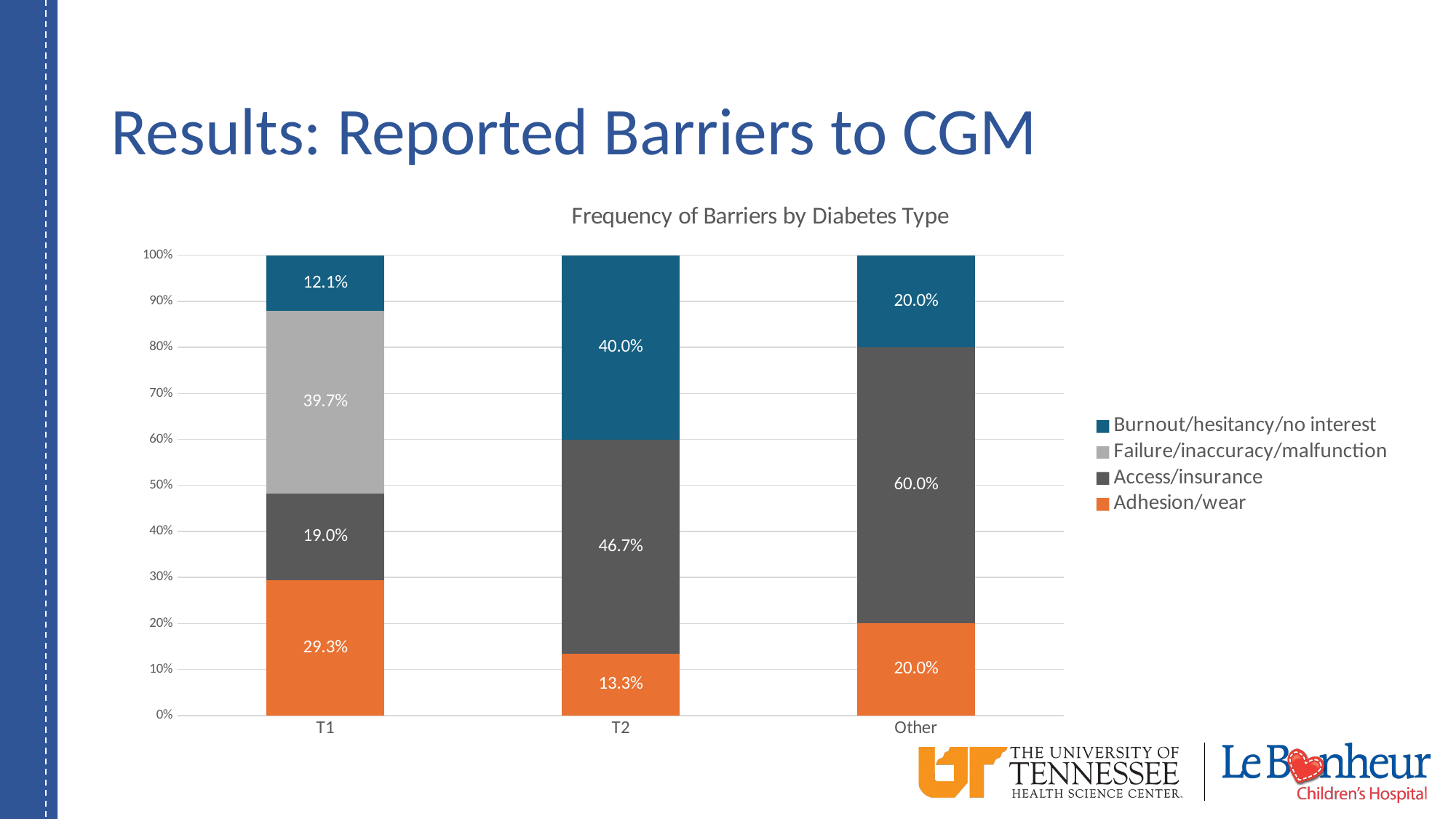
What kind of chart is shown on the slide? Stacked bar chart How many diabetes type categories are shown on the x axis? 3 What is the title of the chart? Frequency of Barriers by Diabetes Type How many series does the legend list? 4 Is the Access/insurance value larger for T1 or for T2? T2 Which diabetes type has the highest value for Access/insurance? Other Which diabetes type has the lowest value for Adhesion/wear? T2 What is the value for Burnout/hesitancy/no interest in the Other bar? 20.0% What is the value for Failure/inaccuracy/malfunction in the T1 bar? 39.7% What is the value for Adhesion/wear in the T1 bar? 29.3% What is the value for Access/insurance in the T2 bar? 46.7% What is the difference between the Burnout/hesitancy/no interest values for T2 and T1? 27.9%